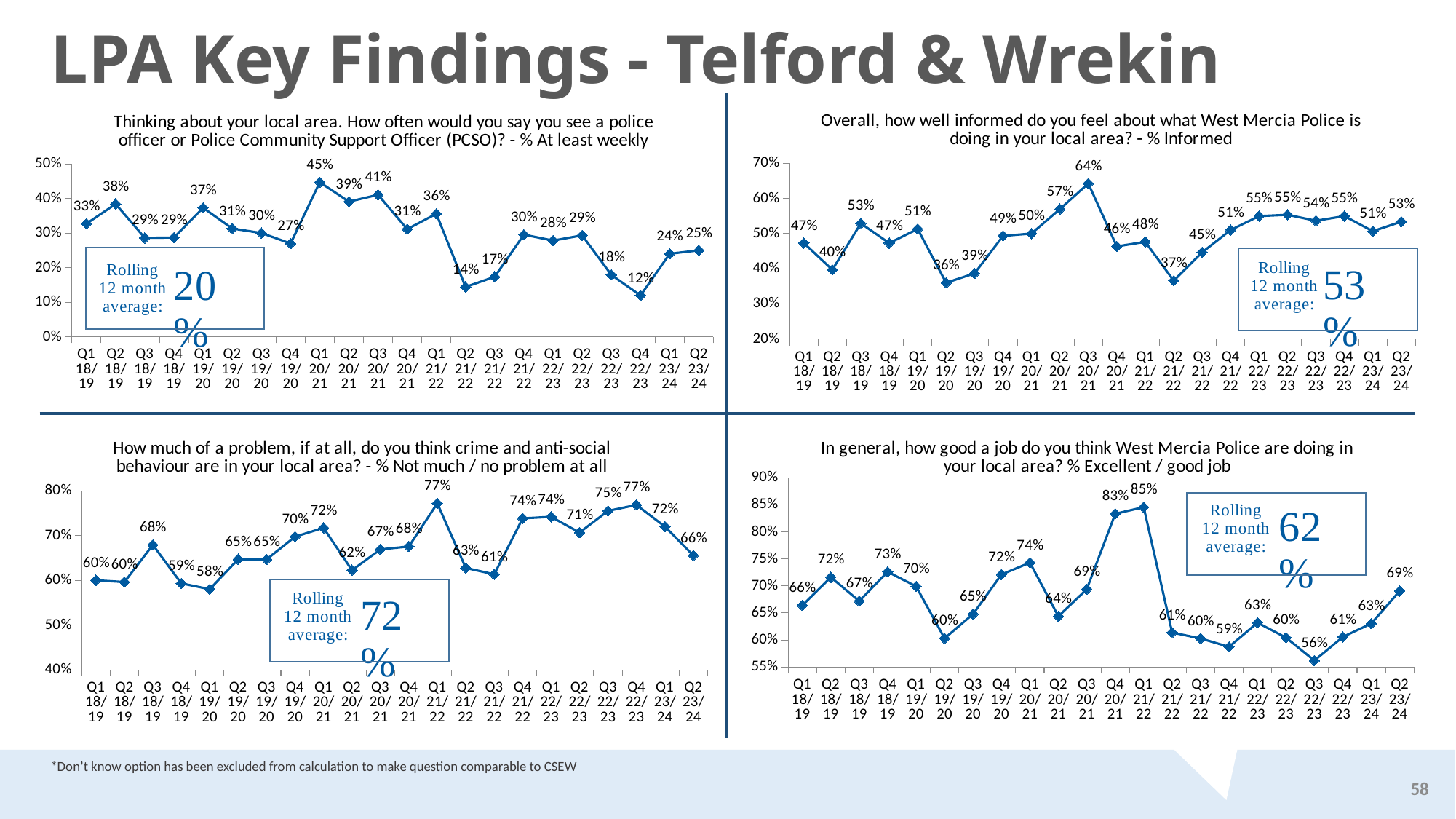
In the bottom-left chart (% not much / no problem with crime and anti-social behaviour), is the value for Q1 21/22 greater or less than 70%? greater In the top-right chart (% informed about what West Mercia Police is doing), what is the value for Q3 20/21? 64% In the top-right chart (% informed about what West Mercia Police is doing), which quarter has the lowest value? Q2 19/20 In the top-right chart (% informed about what West Mercia Police is doing), what is the rolling 12 month average shown? 53% In the top-left chart (% seeing a police officer or PCSO at least weekly), what is the value for Q1 20/21? 45% In the top-left chart (% seeing a police officer or PCSO at least weekly), what is the difference between Q1 20/21 and Q4 22/23? 33 percentage points In the bottom-left chart (% not much / no problem with crime and anti-social behaviour), what is the value for Q2 23/24? 66% In the top-left chart (% seeing a police officer or PCSO at least weekly), which quarter has the lowest value? Q4 22/23 In the bottom-right chart (% excellent / good job), which is larger, the value for Q4 20/21 or the value for Q2 23/24? Q4 20/21 How many quarterly data points are plotted in the bottom-right chart (% excellent / good job)? 22 In the bottom-right chart (% excellent / good job), what is the value for Q3 22/23? 56% In the bottom-right chart (% excellent / good job), which quarter has the highest value? Q1 21/22